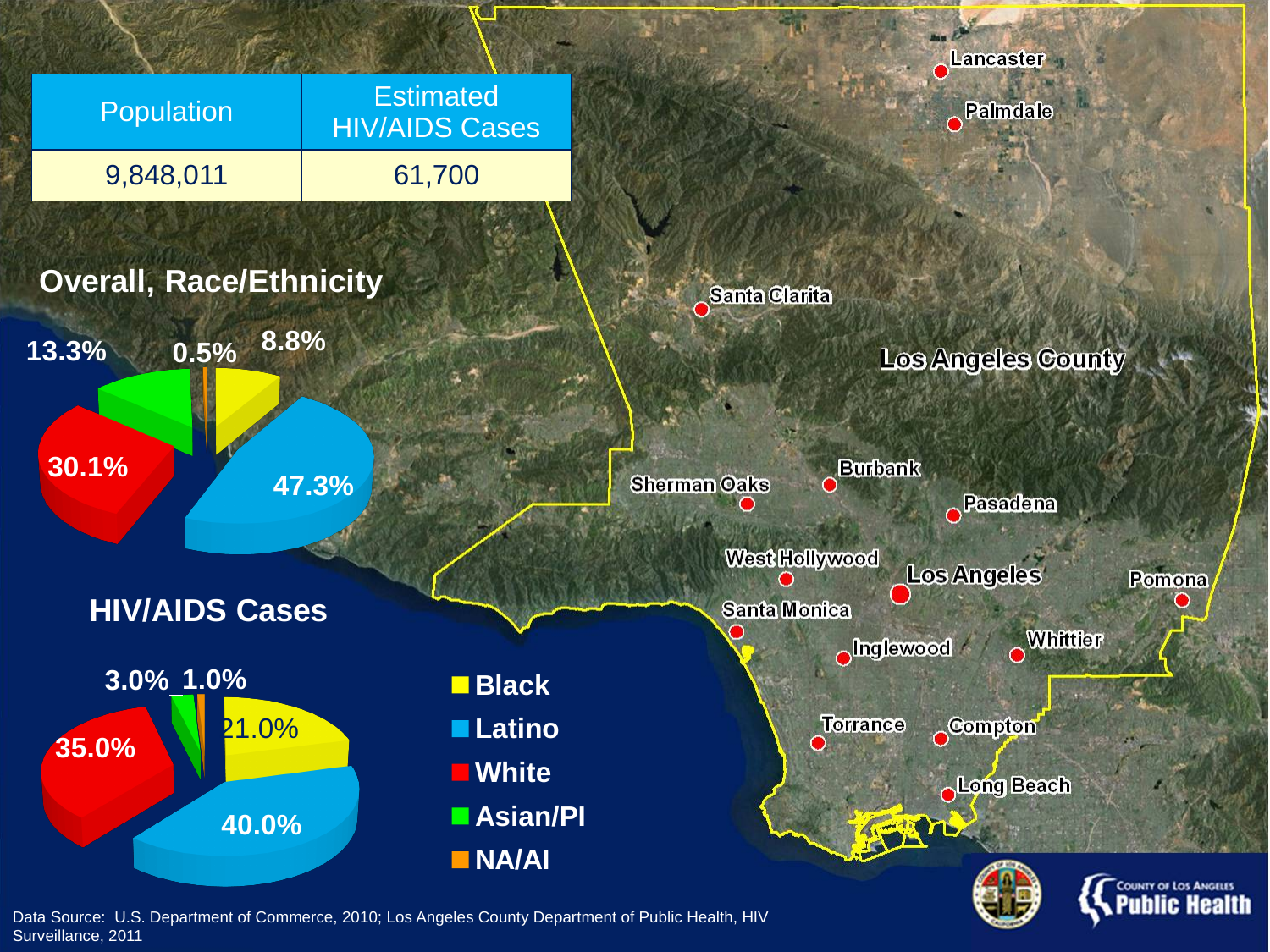
How many groups does the legend list for the pie charts? 5 In the 'HIV/AIDS Cases' pie chart, what share is shown for Black? 21.0% In the 'Overall, Race/Ethnicity' pie chart, which group has the smallest share? NA/AI In the 'HIV/AIDS Cases' pie chart, what share is shown for Latino? 40.0% In the 'HIV/AIDS Cases' pie chart, what is the difference between the White share and the Black share? 14.0% In the 'Overall, Race/Ethnicity' pie chart, what share is shown for White? 30.1% In the 'Overall, Race/Ethnicity' pie chart, what share is shown for Asian/PI? 13.3% In the 'HIV/AIDS Cases' pie chart, which group has the largest share? Latino In the 'HIV/AIDS Cases' pie chart, what share is shown for NA/AI? 1.0% In the 'Overall, Race/Ethnicity' pie chart, which is larger, the share for Black or the share for Asian/PI? Asian/PI What type of chart is used for 'HIV/AIDS Cases'? Pie chart In the 'Overall, Race/Ethnicity' pie chart, what share is shown for Latino? 47.3%